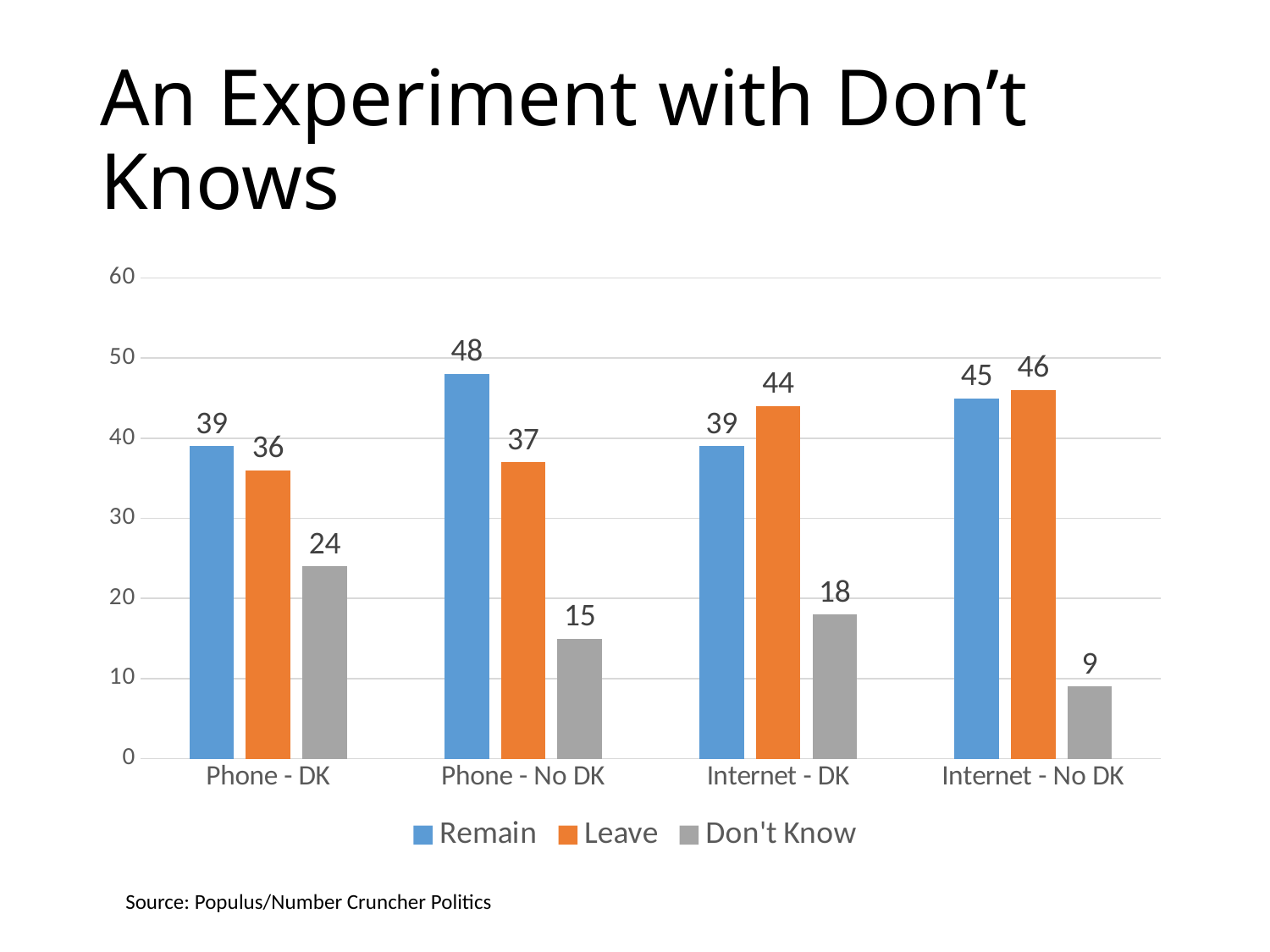
Which category has the lowest Leave value? Phone - DK What is the Leave value for Internet - DK? 44 What is the difference between the Remain and Leave values for Phone - No DK? 11 What is the title of the slide? An Experiment with Don't Knows How many categories are shown on the x axis? 4 How many series does the legend list? 3 Is the Don't Know value for Internet - DK greater or less than 20? less What kind of chart is shown on the slide? Bar chart What is the Don't Know value for Internet - No DK? 9 For Internet - No DK, which is larger, Remain or Leave? Leave Which category has the highest Don't Know value? Phone - DK What is the Remain value for Phone - No DK? 48